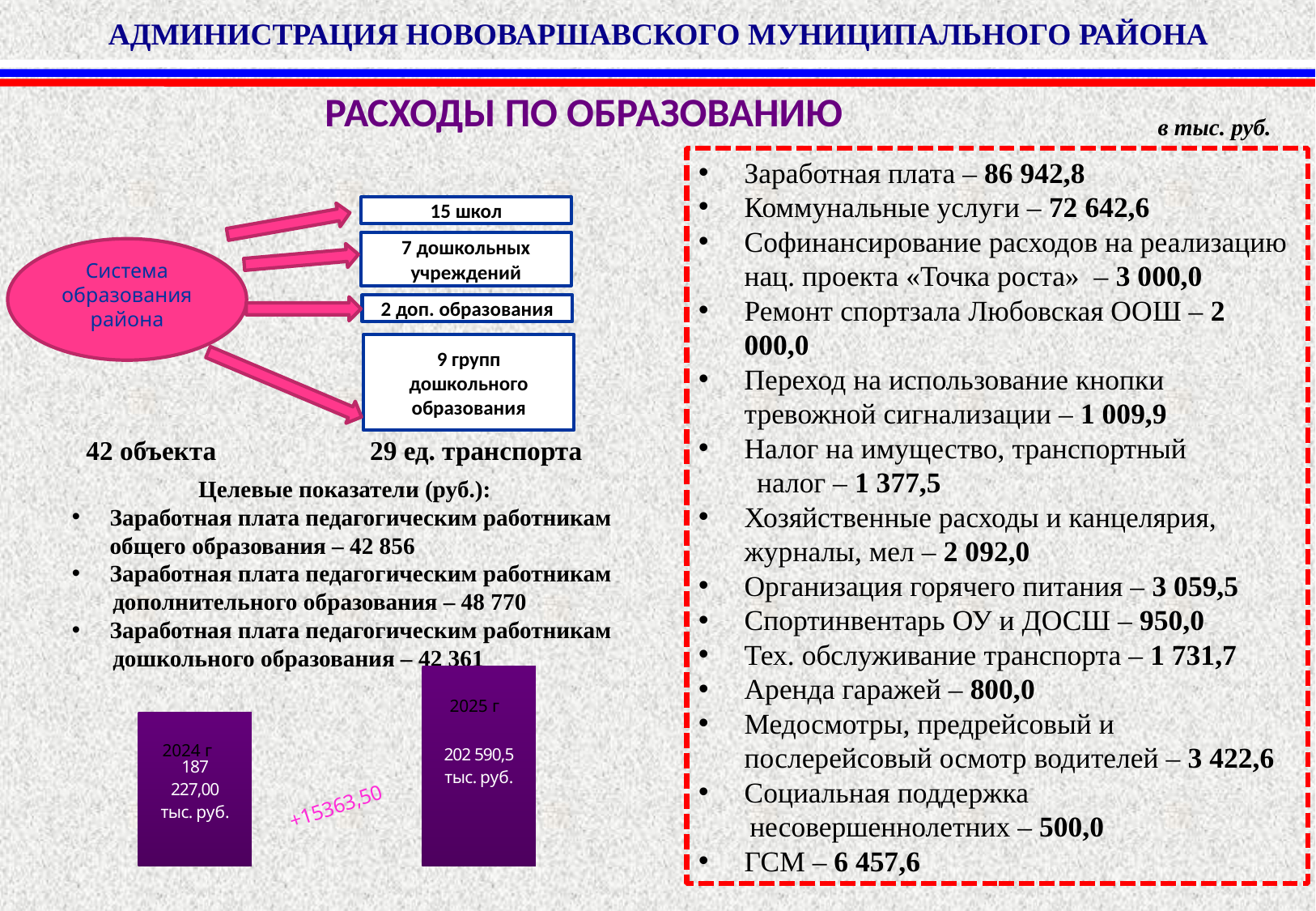
In the bar chart at the bottom left of the slide, by how much does the 2025 г value exceed the 2024 г value? +15363,50 What colour are the bars in the chart at the bottom left of the slide? purple In the bar chart at the bottom left of the slide, what value is shown for 2024 г? 187 227,00 тыс. руб. What kind of chart is shown at the bottom left of the slide? bar chart In the bar chart at the bottom left of the slide, is the value for 2025 г larger or smaller than the value for 2024 г? larger In the bar chart at the bottom left of the slide, what unit is given for the bar values? тыс. руб. In the bar chart at the bottom left of the slide, what value is shown for 2025 г? 202 590,5 тыс. руб. In the bar chart at the bottom left of the slide, do the values rise or fall from 2024 г to 2025 г? rise In the bar chart at the bottom left of the slide, which year has the higher value? 2025 г In the bar chart at the bottom left of the slide, which year has the lower value? 2024 г How many bars are shown in the bar chart at the bottom left of the slide? 2